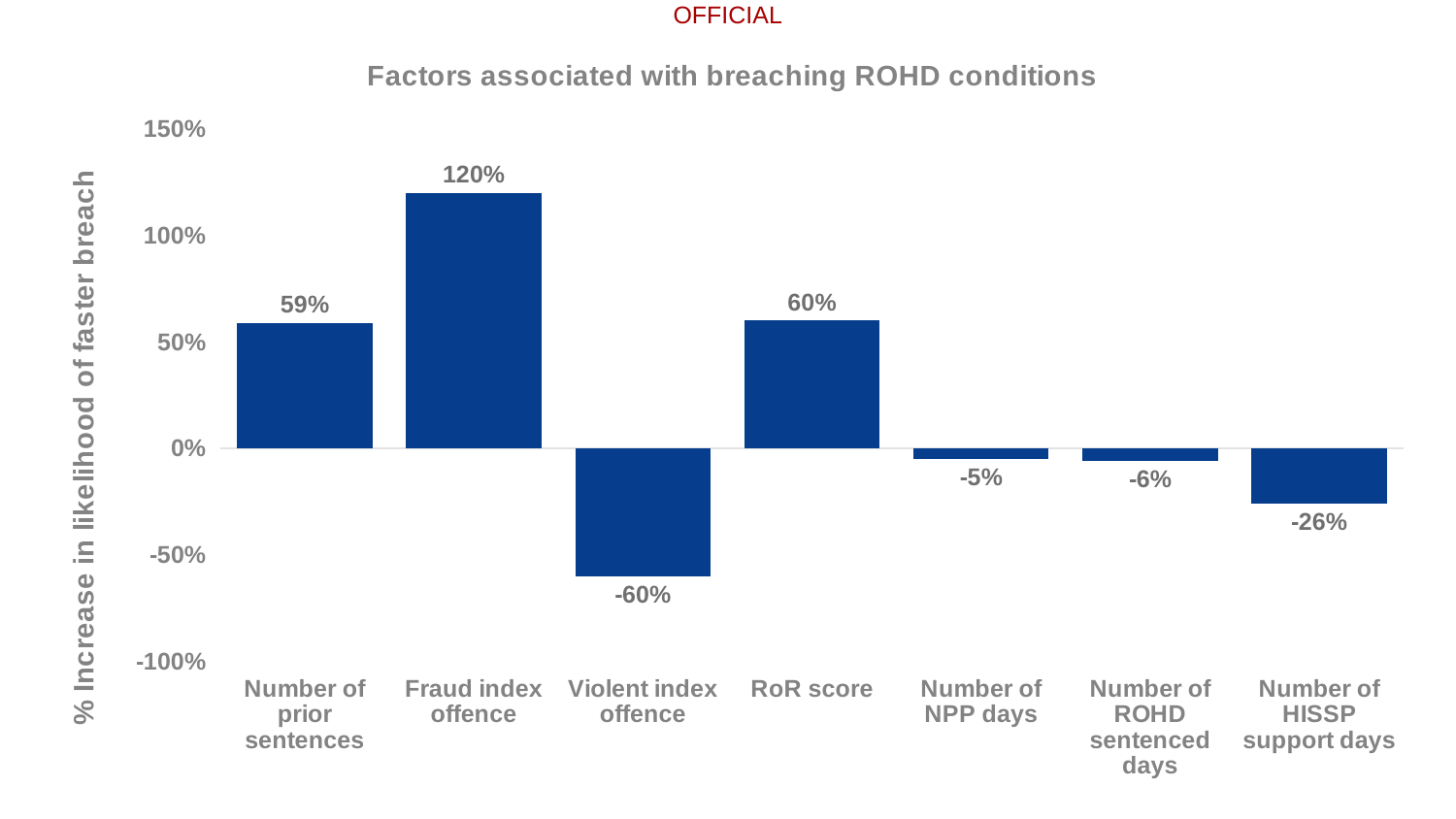
What is the difference between the values for Fraud index offence and RoR score? 60% What is the value for Number of HISSP support days? -26% What is the title of the chart? Factors associated with breaching ROHD conditions What is the value for Fraud index offence? 120% What kind of chart is shown on the slide? Bar chart How many categories are shown on the x axis? 7 Which category has the lowest value? Violent index offence What is the value for Violent index offence? -60% Which is larger, the value for Number of prior sentences or the value for Fraud index offence? Fraud index offence What is the value for Number of NPP days? -5% Is the value for Number of prior sentences greater or less than 50%? greater Which category has the highest value? Fraud index offence